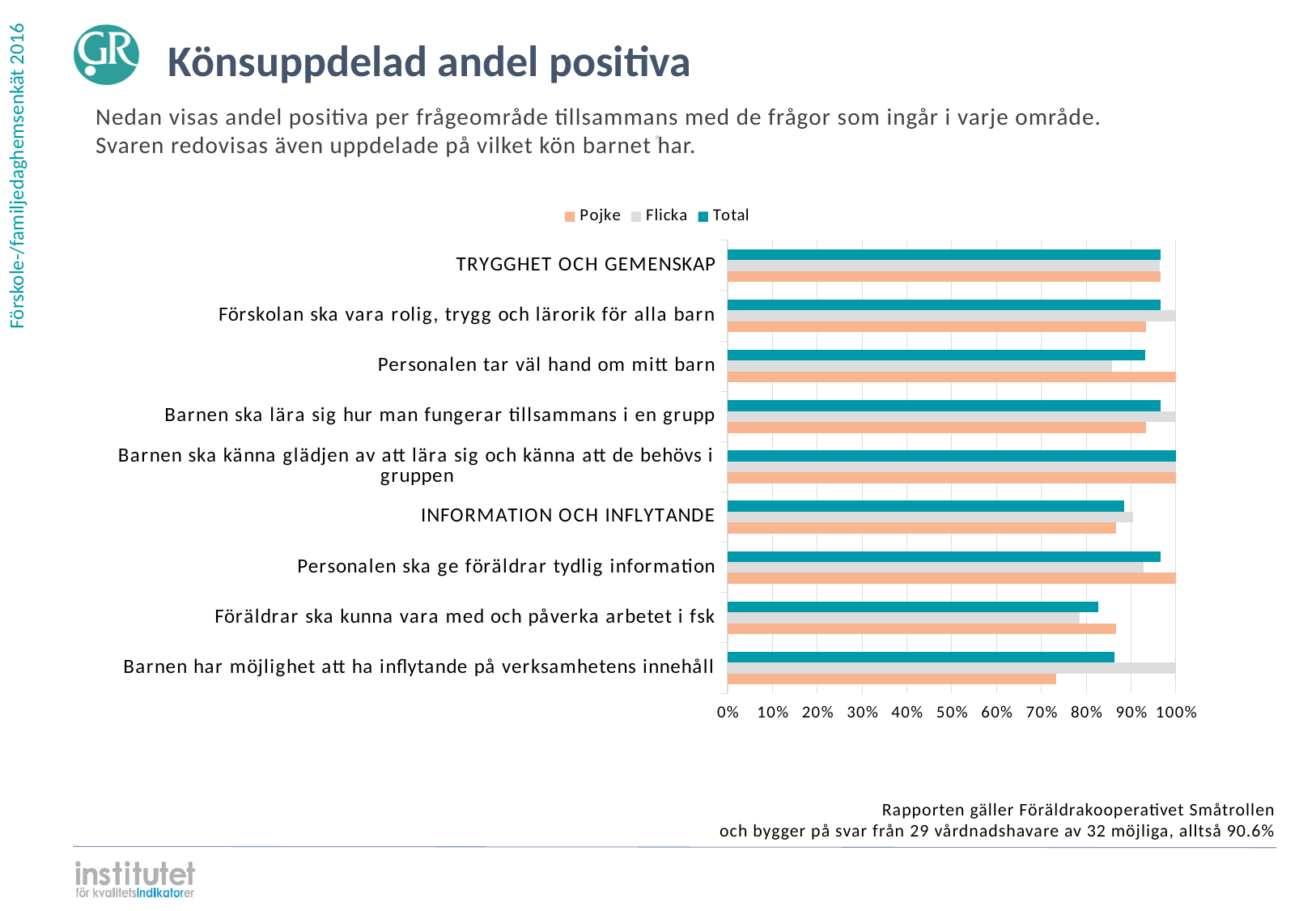
What is the Pojke value for 'Personalen tar väl hand om mitt barn'? 100% Is the Total value for 'Föräldrar ska kunna vara med och påverka arbetet i fsk' greater or less than 80%? greater How many categories are shown on the chart? 9 For 'Barnen har möjlighet att ha inflytande på verksamhetens innehåll', which is larger, the Pojke value or the Flicka value? Flicka Is the Pojke value for 'Barnen har möjlighet att ha inflytande på verksamhetens innehåll' greater or less than 80%? less How many series does the legend list? 3 What is the title of the slide? Könsuppdelad andel positiva Which category has the lowest Pojke value? Barnen har möjlighet att ha inflytande på verksamhetens innehåll What kind of chart is shown on the slide? bar chart What is the Total value for 'Barnen ska känna glädjen av att lära sig och känna att de behövs i gruppen'? 100% For 'Personalen tar väl hand om mitt barn', which is larger, the Pojke value or the Flicka value? Pojke What are the series names listed in the legend? Pojke, Flicka, Total